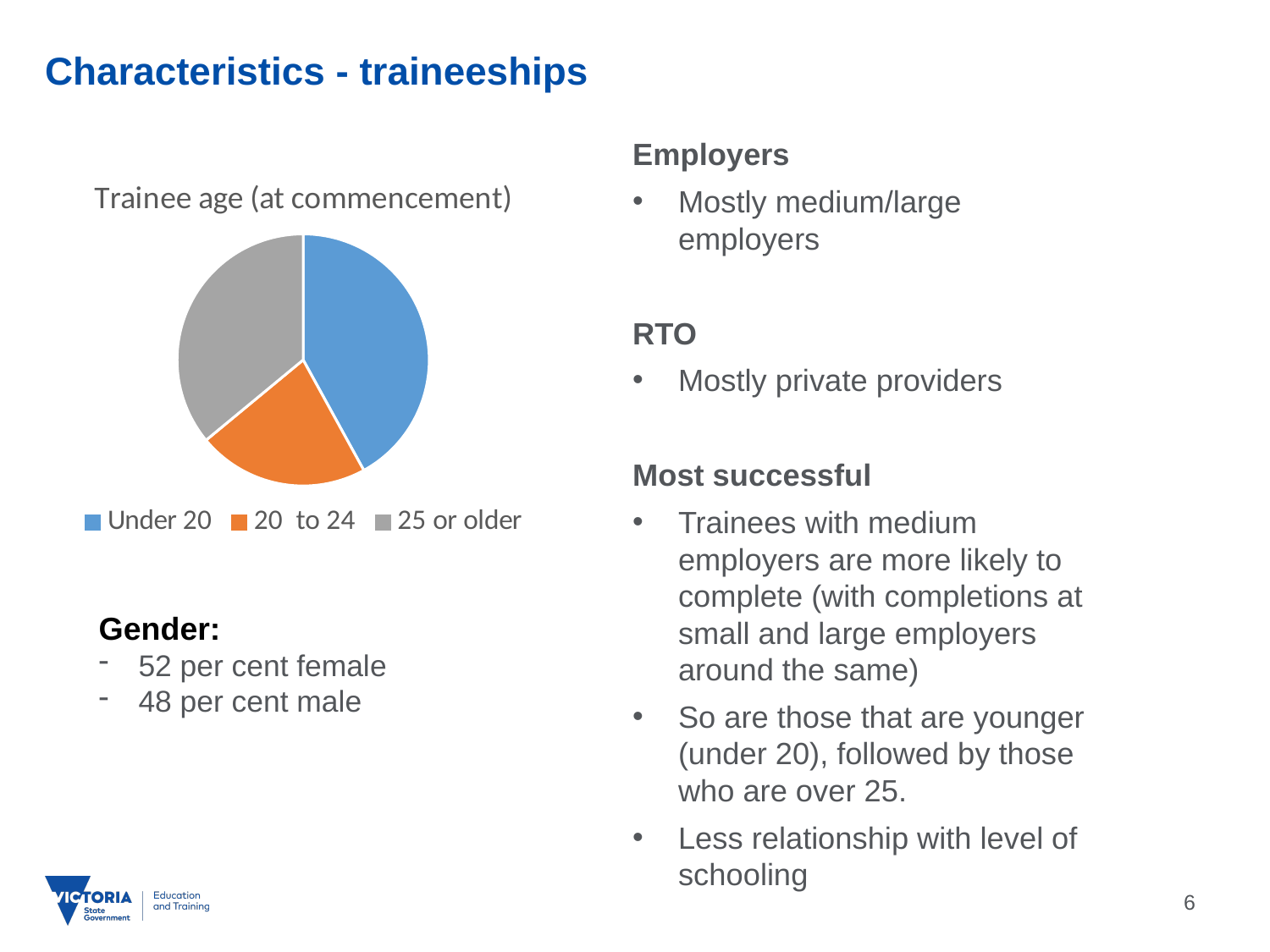
Which slice is larger in the pie chart: 25 or older or 20 to 24? 25 or older Which colour represents the 20 to 24 category in the pie chart? orange What is the title of the pie chart? Trainee age (at commencement) What kind of chart is shown on the slide? pie chart How many age categories does the pie chart show? 3 Which age category has the smallest slice in the pie chart? 20 to 24 Which slice is larger in the pie chart: Under 20 or 20 to 24? Under 20 What are the three categories listed in the pie chart legend? Under 20, 20 to 24, 25 or older